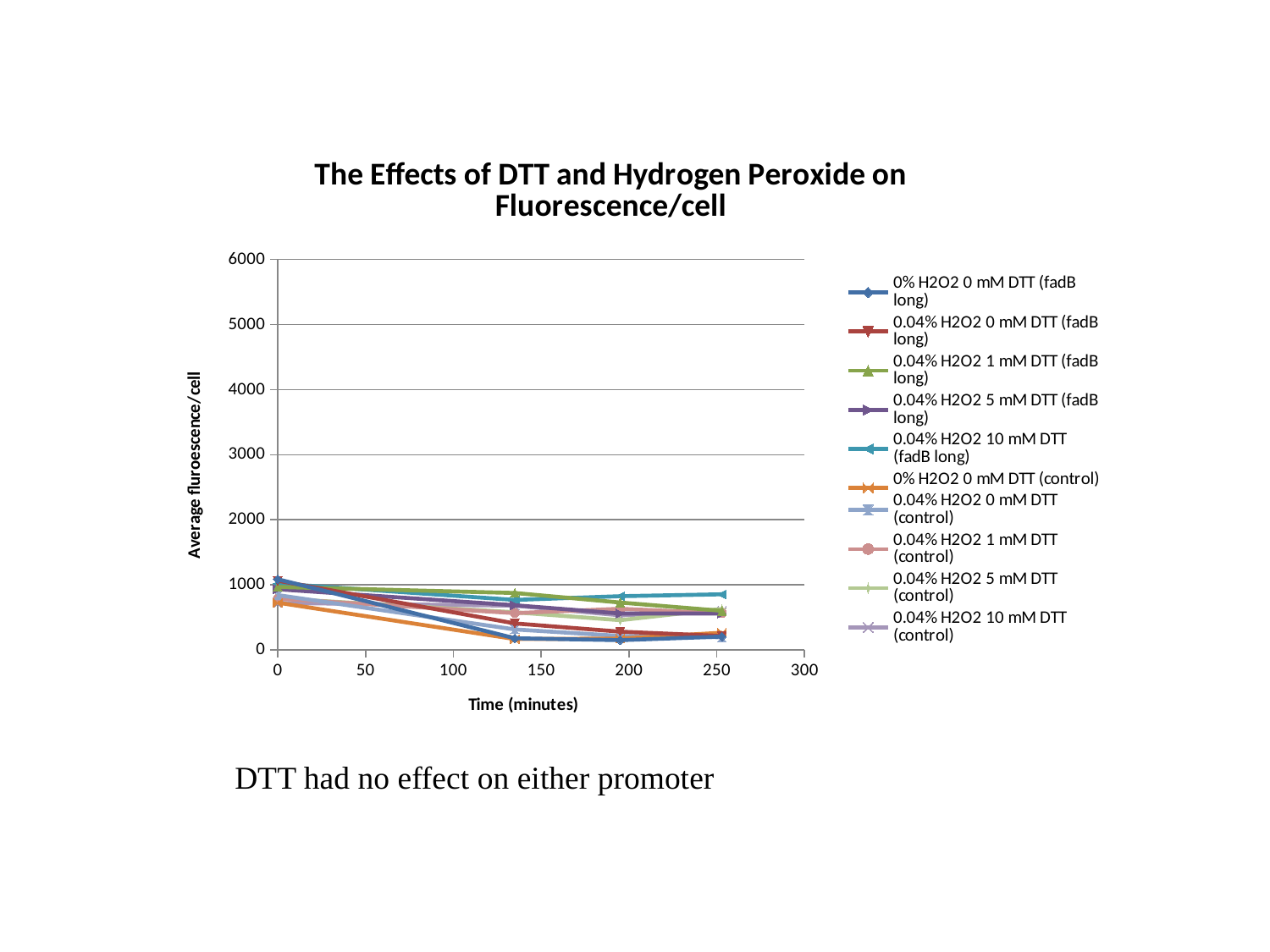
How many series does the legend list? 10 Is the value for 0% H2O2 0 mM DTT (control) at time 0 greater or less than 1000? less What is the highest value shown on the y axis? 6000 At around 200 minutes, which is larger: the value for 0.04% H2O2 10 mM DTT (fadB long) or the value for 0% H2O2 0 mM DTT (fadB long)? 0.04% H2O2 10 mM DTT (fadB long) Do the values for 0% H2O2 0 mM DTT (control) rise or fall as time increases? fall Is the value for 0% H2O2 0 mM DTT (fadB long) at time 200 greater or less than 1000? less What kind of chart is shown on the slide? line chart What is the label of the y axis? Average fluroescence/cell What is the title of the chart? The Effects of DTT and Hydrogen Peroxide on Fluorescence/cell Do the values for 0% H2O2 0 mM DTT (fadB long) rise or fall as time increases? fall Is the value for 0% H2O2 0 mM DTT (fadB long) at time 0 greater or less than 2000? less